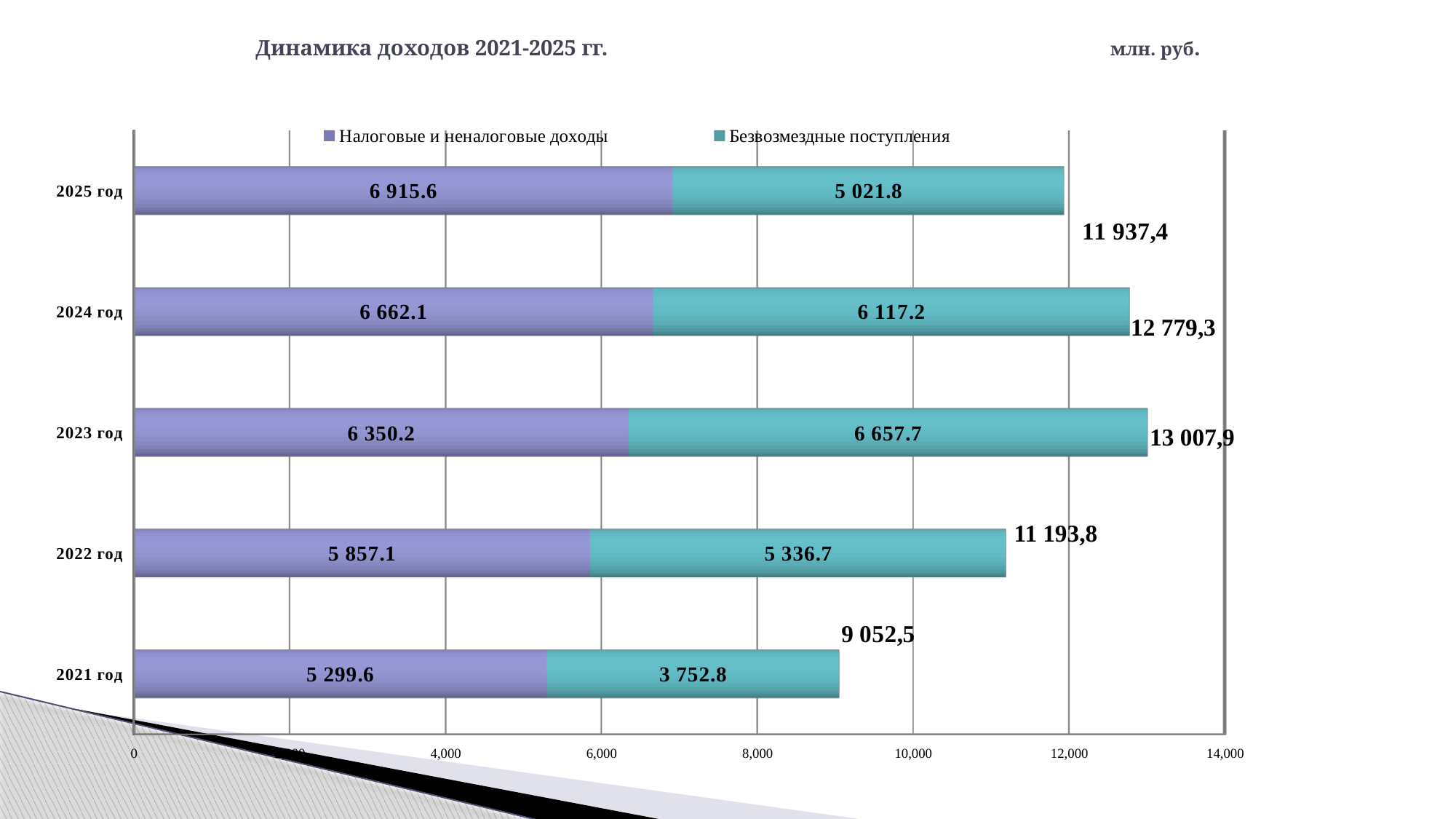
What is the value of Налоговые и неналоговые доходы for 2025 год? 6 915.6 What is the total income shown for 2023 год? 13 007,9 Which year has the lowest value of Безвозмездные поступления? 2021 год Which year has the highest total income? 2023 год What is the difference between Налоговые и неналоговые доходы in 2025 год and 2024 год? 253.5 How many series does the legend list? 2 What is the value of Безвозмездные поступления for 2021 год? 3 752.8 Do the values of Налоговые и неналоговые доходы rise or fall from 2021 год to 2025 год? Rise What is the title of the chart? Динамика доходов 2021-2025 гг. What type of chart is shown on the slide? Stacked bar chart How many years are shown on the chart? 5 In 2023 год, which is larger: Налоговые и неналоговые доходы or Безвозмездные поступления? Безвозмездные поступления